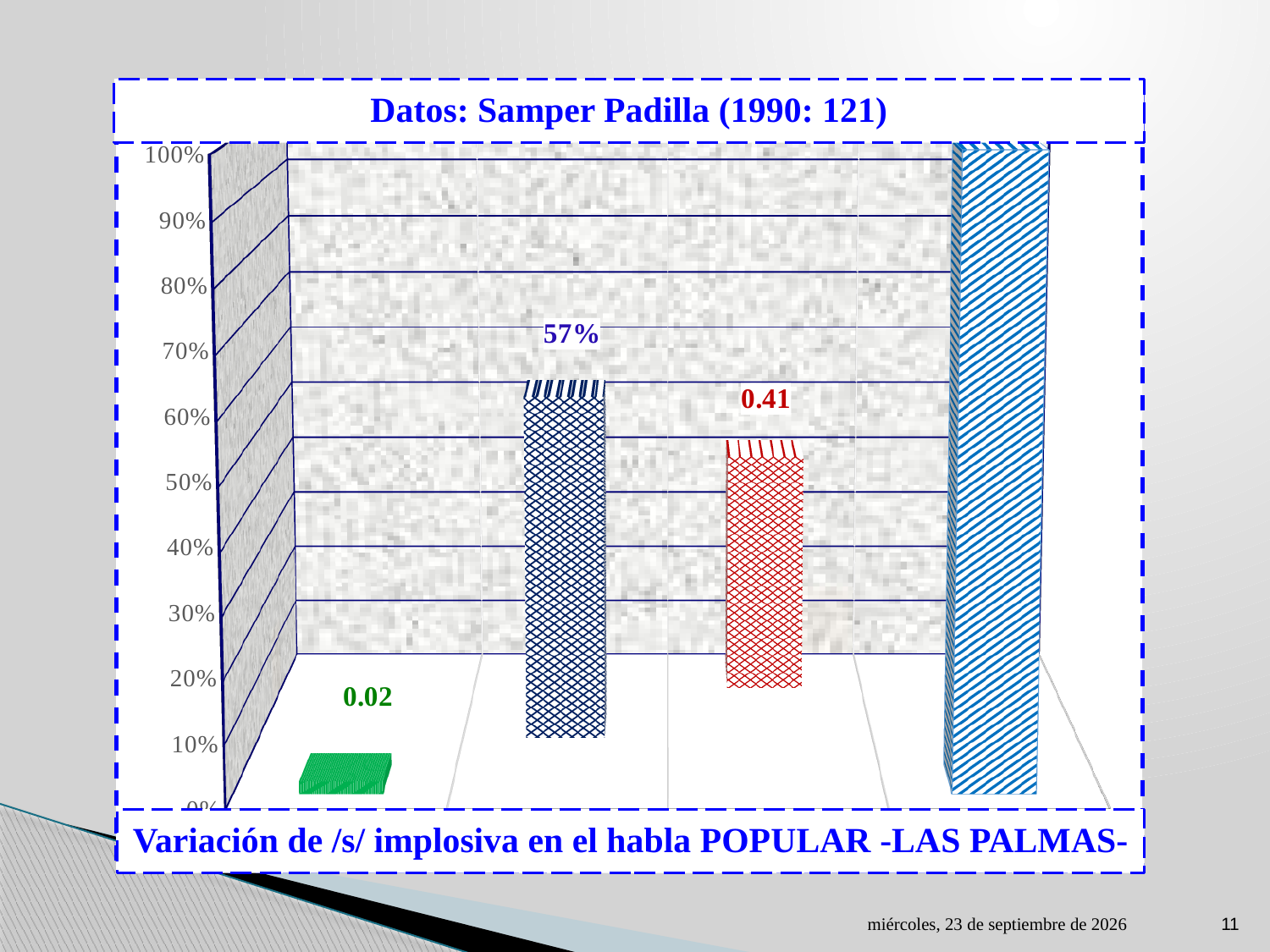
Is the value of the green bar greater or less than 10%? less What value is labelled on the green bar (first from the left)? 0.02 Which bar is the shortest in the chart? the green bar on the left What kind of chart is shown on the slide? bar chart What caption appears below the chart? Variación de /s/ implosiva en el habla POPULAR -LAS PALMAS- What value is labelled on the red bar (third from the left)? 0.41 What value is labelled on the dark blue crosshatched bar (second from the left)? 57% How many bars are plotted in the chart? 4 Which bar is the tallest in the chart? the rightmost light blue striped bar Which is taller, the dark blue crosshatched bar or the red bar? the dark blue crosshatched bar Is the value of the rightmost light blue striped bar greater or less than 90%? greater What is the title shown above the chart? Datos: Samper Padilla (1990: 121)